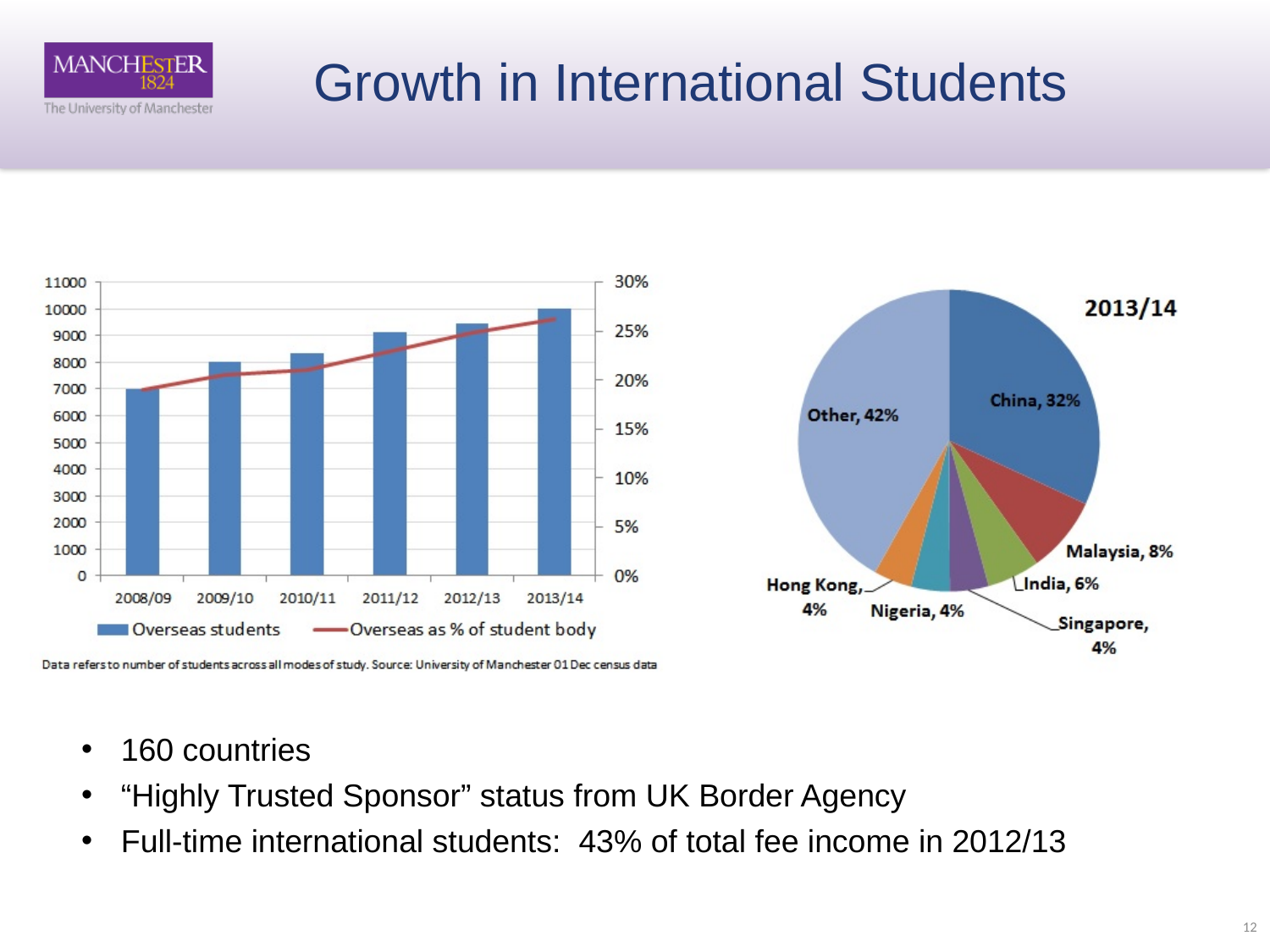
In the chart on the left, how many series does the legend list? 2 In the pie chart on the right, which named country (excluding Other) has the largest share? China In the pie chart on the right, what share of international students comes from China? 32% In the pie chart on the right, which is larger, the share for India or the share for Malaysia? Malaysia In the chart on the left, is the number of overseas students in 2012/13 greater or less than 9000? greater In the chart on the left, which academic year has the highest number of overseas students? 2013/14 In the pie chart on the right, what share is labelled Malaysia? 8% In the pie chart on the right, which academic year does the chart refer to? 2013/14 In the pie chart on the right, how many slices are shown? 7 In the chart on the left, do the overseas student numbers rise or fall from 2008/09 to 2013/14? rise In the pie chart on the right, what is the difference between the Other share and the China share? 10% In the chart on the left, how many academic years are shown on the x axis? 6